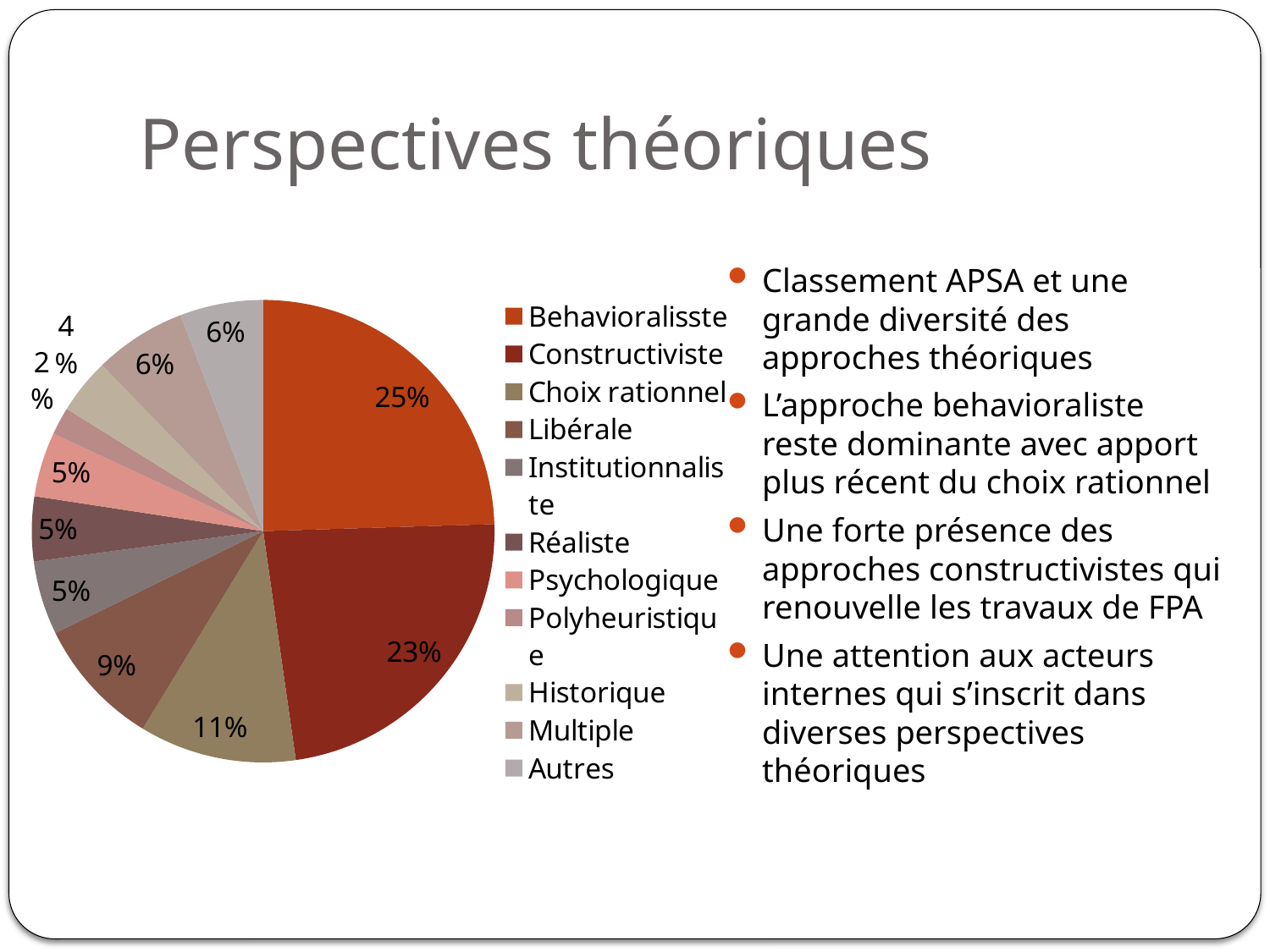
What percentage does the Constructiviste slice show? 23% What percentage of the pie chart is labelled for Behavioralisste? 25% What percentage is shown for the Autres slice? 6% What type of chart is shown on the slide? Pie chart What share of the pie does the Behavioralisste slice represent? 25% What is the difference in percentage points between the Behavioralisste and Constructiviste slices? 2 percentage points What percentage is shown for the Libérale slice? 9% What is the value shown for Choix rationnel? 11% Which category appears first in the chart's legend? Behavioralisste Which category has the largest slice of the pie chart? Behavioralisste Which slice is larger, Choix rationnel or Libérale? Choix rationnel How many categories are listed in the pie chart's legend? 11